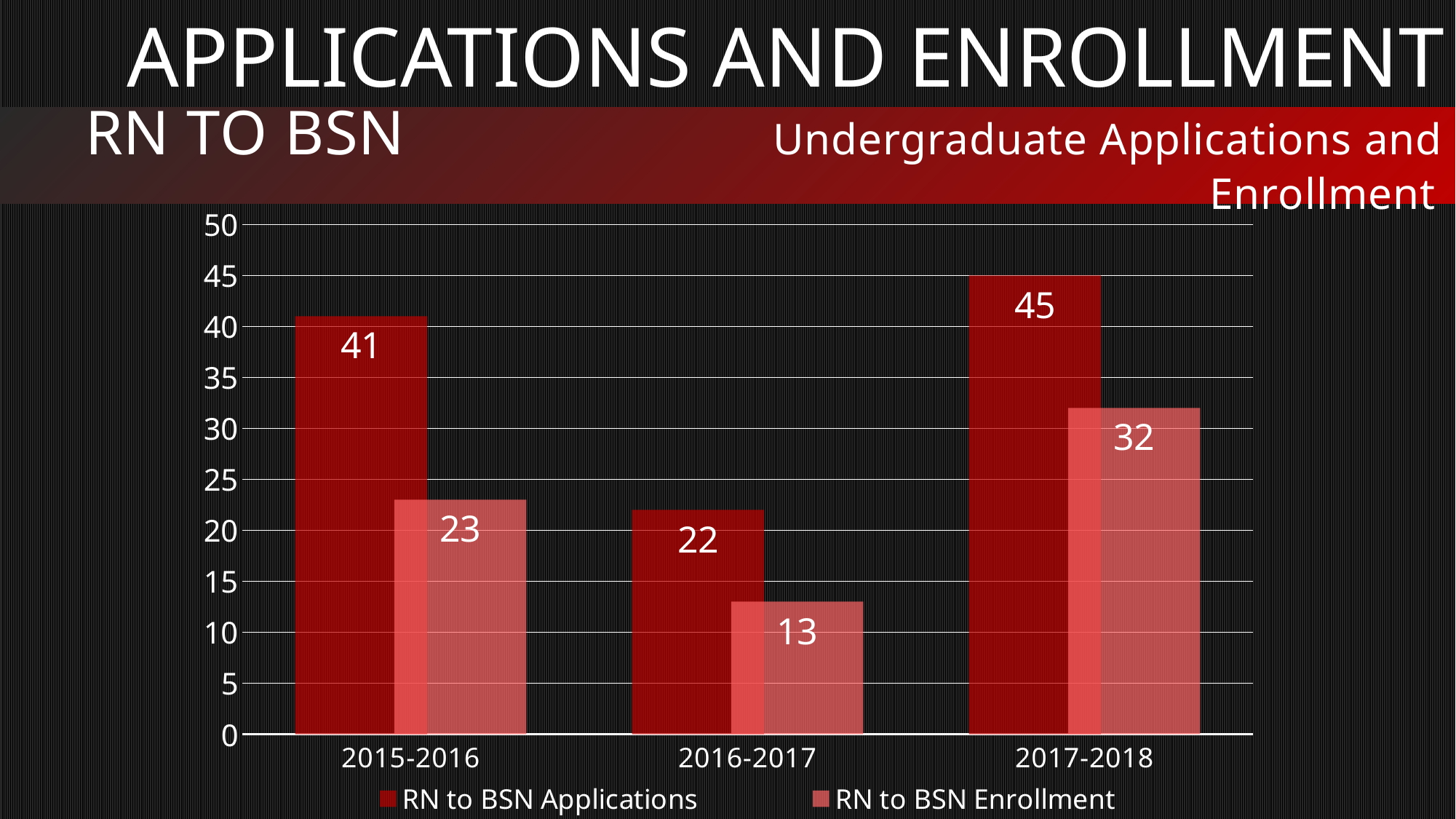
Which year has the lowest RN to BSN Enrollment value? 2016-2017 What kind of chart is shown on the slide? bar chart Is the value for RN to BSN Applications in 2016-2017 greater or less than 25? less What is the value for RN to BSN Enrollment in 2017-2018? 32 What is the title of the chart? Undergraduate Applications and Enrollment What is the difference between RN to BSN Applications and RN to BSN Enrollment in 2015-2016? 18 How many year categories are shown on the x axis? 3 Which is larger: RN to BSN Enrollment in 2017-2018 or RN to BSN Applications in 2015-2016? RN to BSN Applications in 2015-2016 Which year has the highest RN to BSN Applications value? 2017-2018 What is the value for RN to BSN Applications in 2015-2016? 41 What is the value for RN to BSN Enrollment in 2016-2017? 13 How many series does the legend list? 2